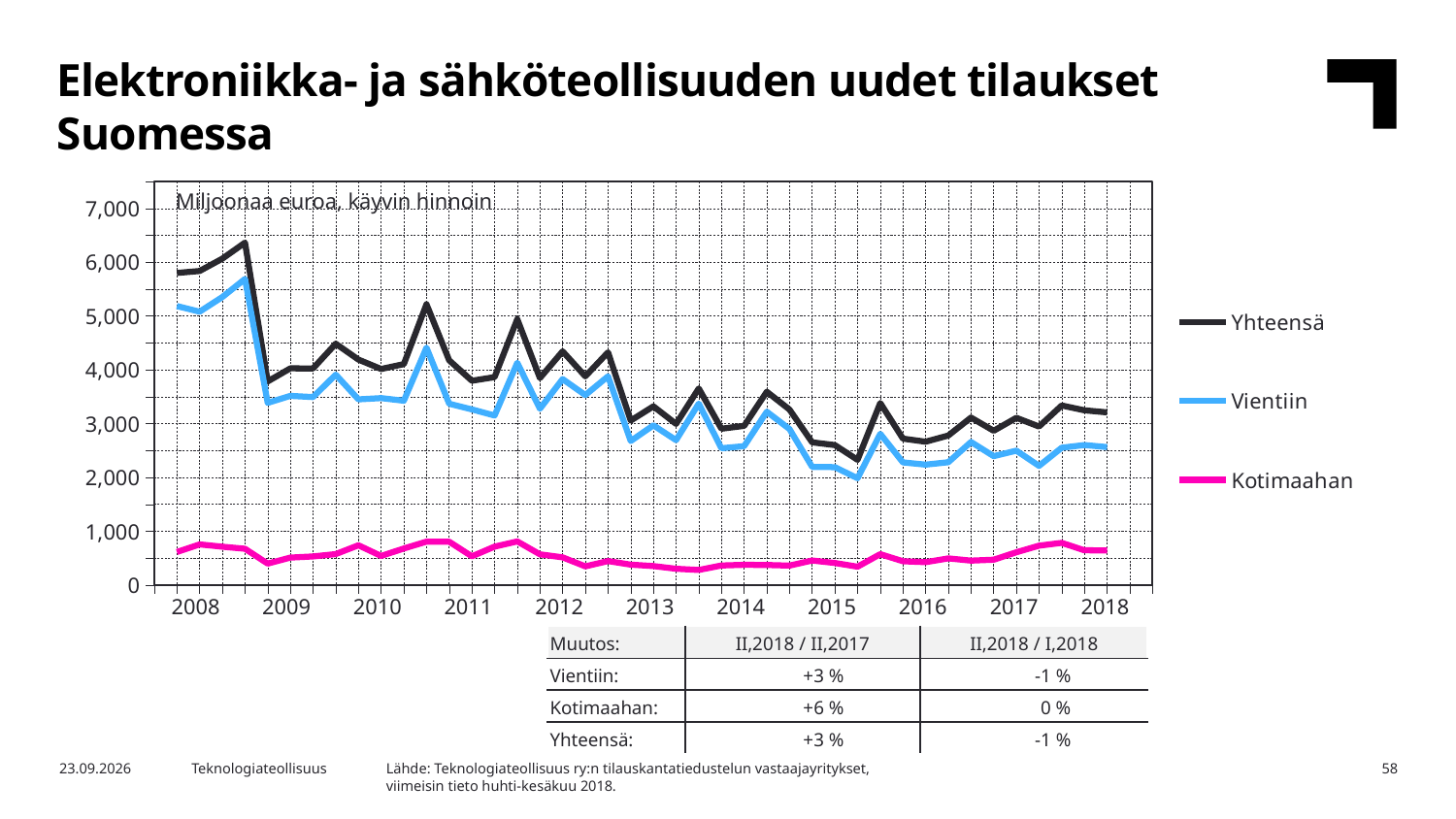
Is the value for Kotimaahan in 2018 greater or less than 1,000? less Does the Yhteensä series overall rise or fall from 2008 to 2018? fall Which series has the highest values throughout the chart? Yhteensä How many year labels are shown on the x axis? 11 What are the series names listed in the legend? Yhteensä, Vientiin, Kotimaahan How many series does the legend list? 3 Is the value for Vientiin in 2018 greater or less than 3,000? less What kind of chart is shown on the slide? line chart Which series has the lowest values throughout the chart? Kotimaahan Which is larger in 2018, the value for Vientiin or the value for Kotimaahan? Vientiin Is the value for Yhteensä at the start of 2008 greater or less than 5,000? greater What unit is stated in the chart's subtitle? Miljoonaa euroa, käyvin hinnoin